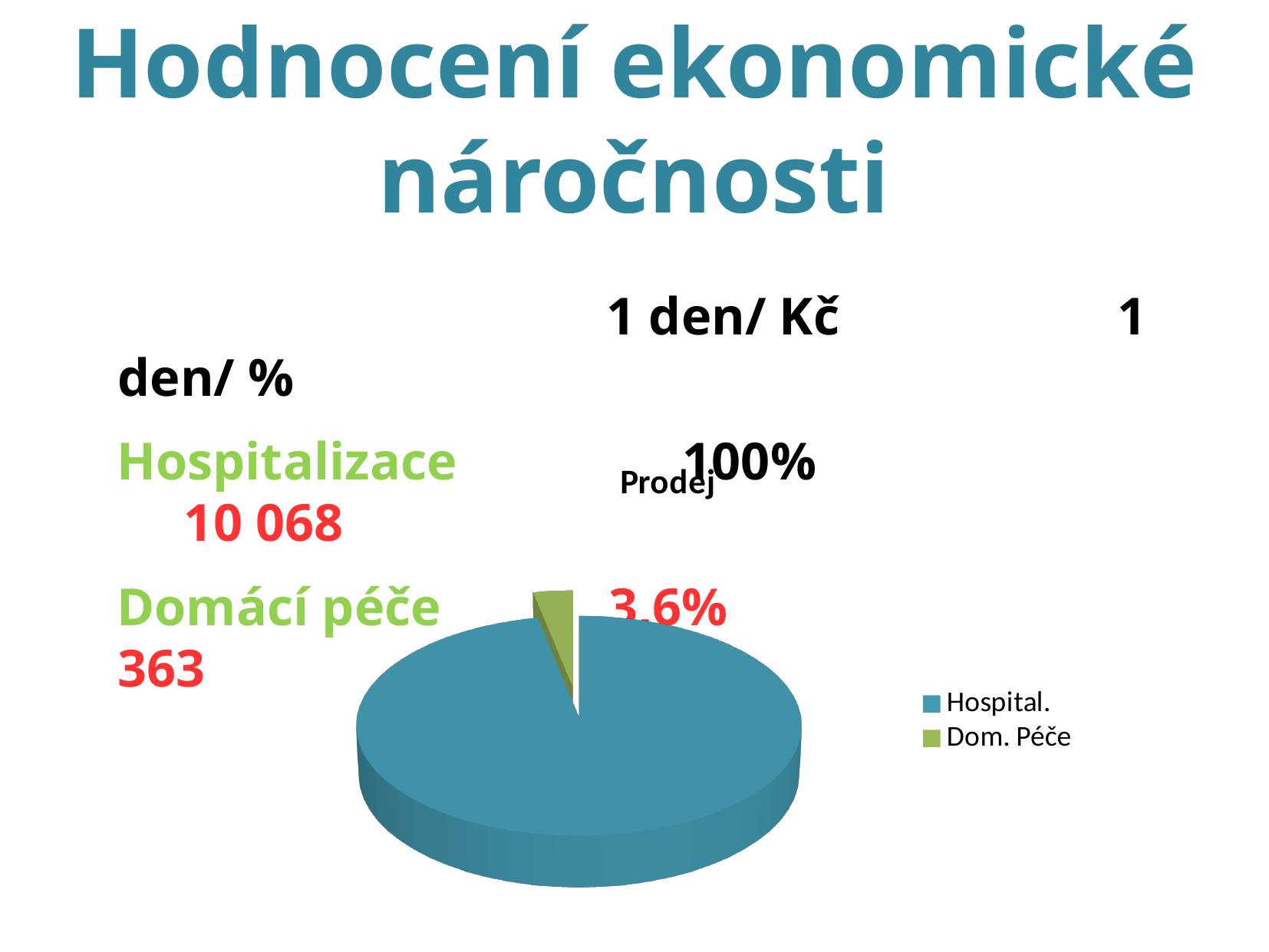
What colour is the Dom. Péče slice in the pie chart? green How many entries does the legend of the pie chart list? 2 What is the title of the pie chart? Prodej How many slices does the pie chart have? 2 Which category has the largest slice in the pie chart? Hospital. What kind of chart is shown on the slide? pie chart Which category has the smallest slice in the pie chart? Dom. Péče Which slice is larger in the pie chart, Hospital. or Dom. Péče? Hospital.